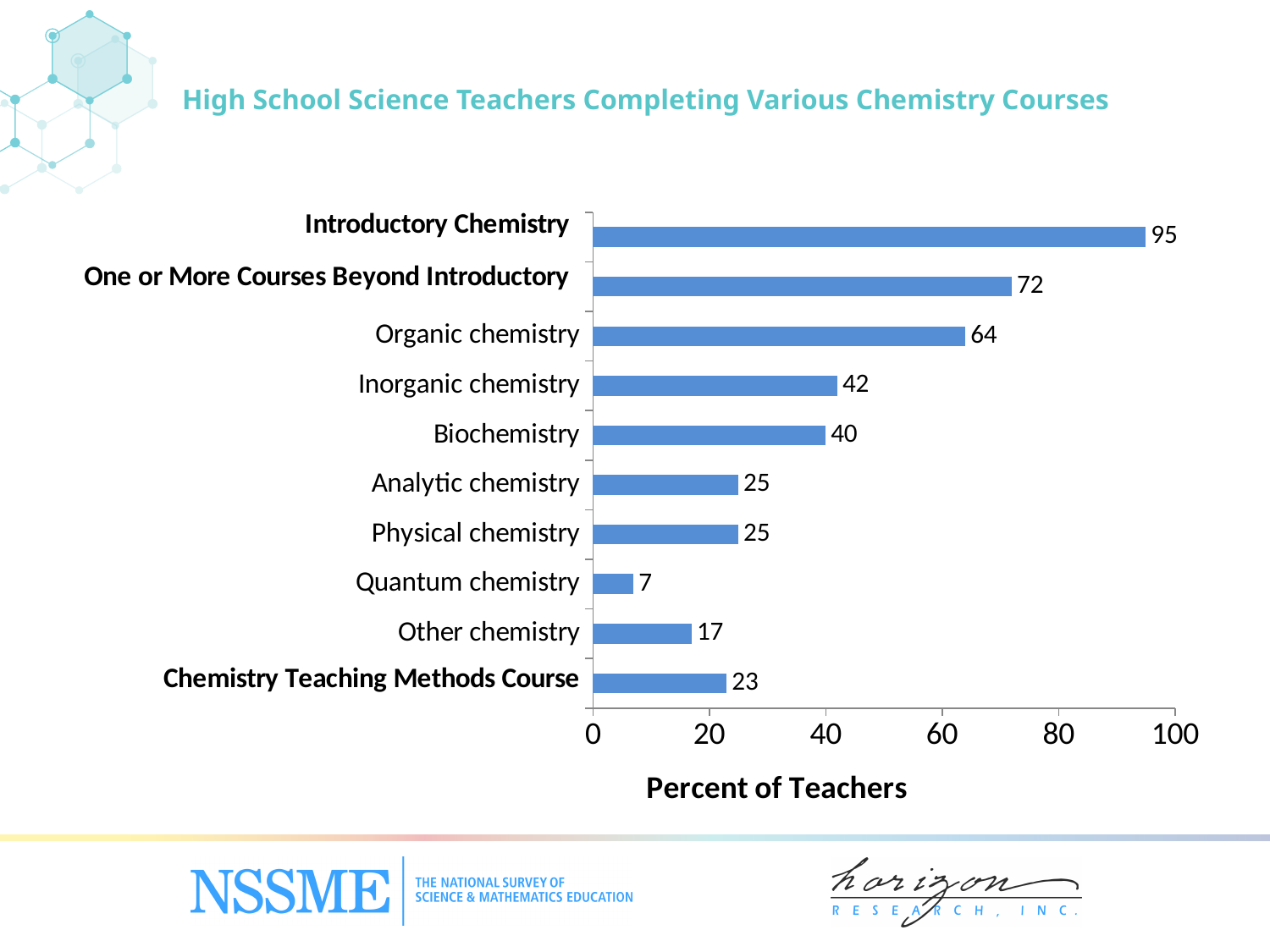
What is the label of the horizontal axis? Percent of Teachers Which is larger, the value for Other chemistry or the value for Chemistry Teaching Methods Course? Chemistry Teaching Methods Course What is the difference between the values for Inorganic chemistry and Biochemistry? 2 What percent of teachers completed Introductory Chemistry? 95 What kind of chart is shown on the slide? Bar chart Which course has the highest percent of teachers? Introductory Chemistry What is the difference between the values for Introductory Chemistry and One or More Courses Beyond Introductory? 23 What is the value for Organic chemistry? 64 Which course has the lowest percent of teachers? Quantum chemistry How many categories are shown in the chart? 10 What percent of teachers completed a Chemistry Teaching Methods Course? 23 What is the value for Quantum chemistry? 7